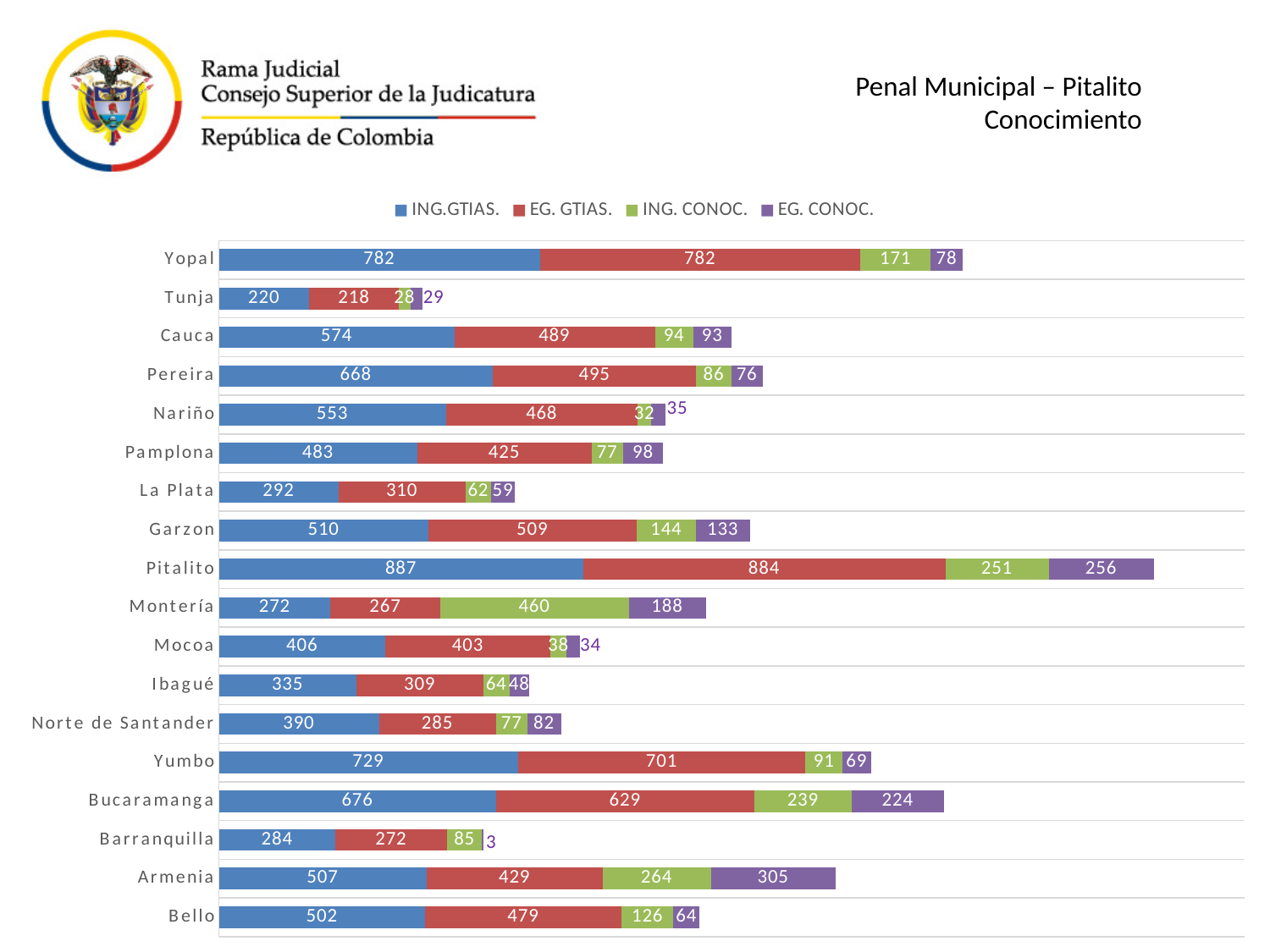
How many series does the legend list? 4 Which category has the highest ING.GTIAS. value? Pitalito What is the difference between the ING.GTIAS. and EG. GTIAS. values for Pereira? 173 What is the EG. CONOC. value for Armenia? 305 Which is larger, the EG. GTIAS. value for Yumbo or the EG. GTIAS. value for Bucaramanga? Yumbo What type of chart is shown on the slide? Stacked horizontal bar chart What is the ING. CONOC. value for Montería? 460 What is the ING.GTIAS. value for Pitalito? 887 What is the title shown at the top right of the slide? Penal Municipal – Pitalito Conocimiento How many categories (cities/districts) are shown on the chart? 18 What is the total of the stacked bar for Tunja? 495 Which category has the lowest EG. CONOC. value? Barranquilla